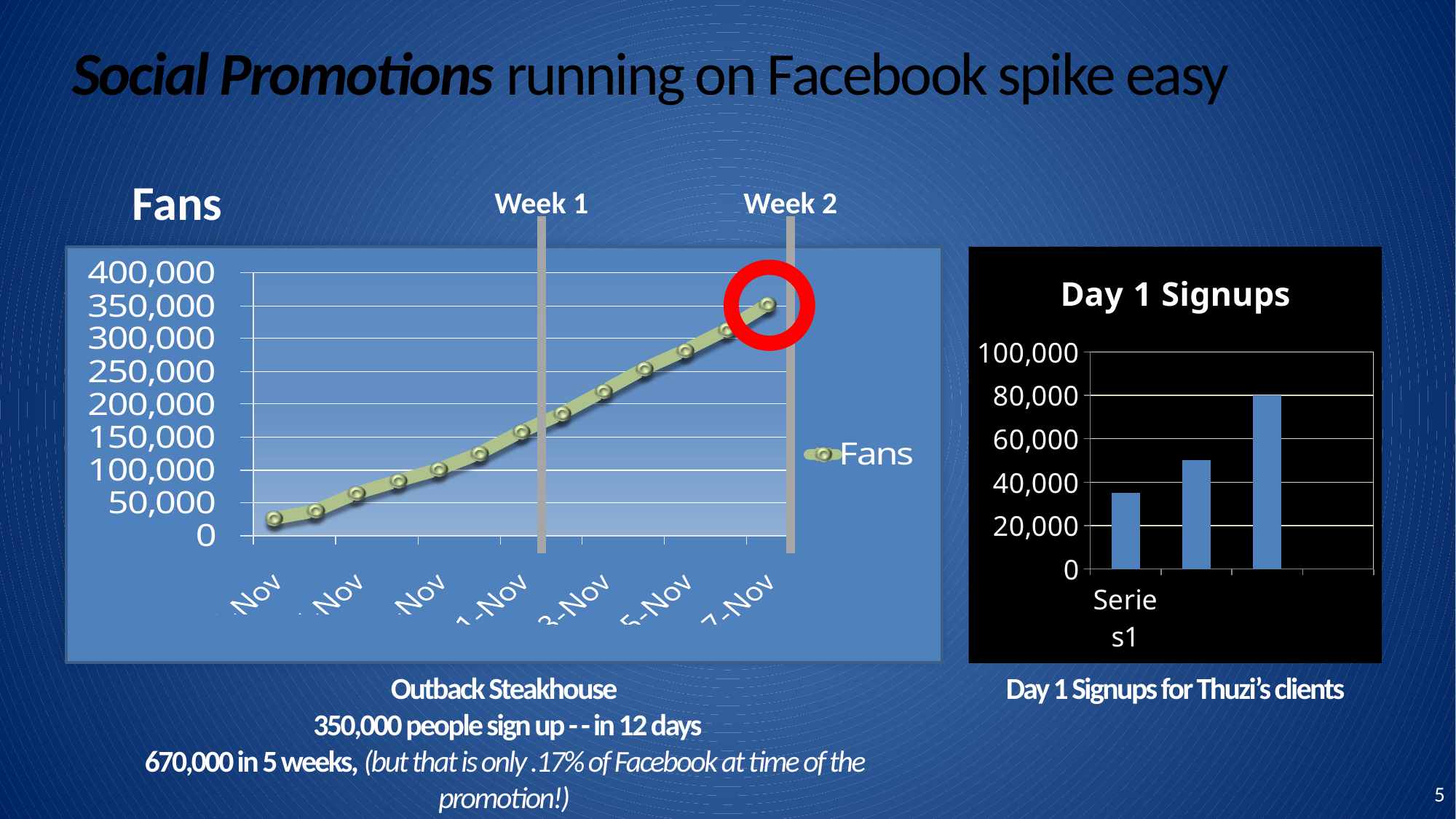
How many series does the legend of the left Fans chart list? 1 What kind of chart is the left chart labelled Fans? line chart In the left Fans chart, is the value at the first point greater or less than 50,000? less In the Day 1 Signups chart, is the value of the rightmost bar greater or less than 60,000? greater How many bars are plotted in the Day 1 Signups chart? 3 In the Day 1 Signups chart, which bar is the tallest? the rightmost bar What is the name of the series shown in the legend of the left Fans chart? Fans What kind of chart is the Day 1 Signups chart on the right? bar chart In the Day 1 Signups chart, which bar is the shortest? the leftmost bar In the Day 1 Signups chart, is the value of the leftmost bar greater or less than 40,000? less In the left Fans chart, do the values rise or fall along the x axis from left to right? rise